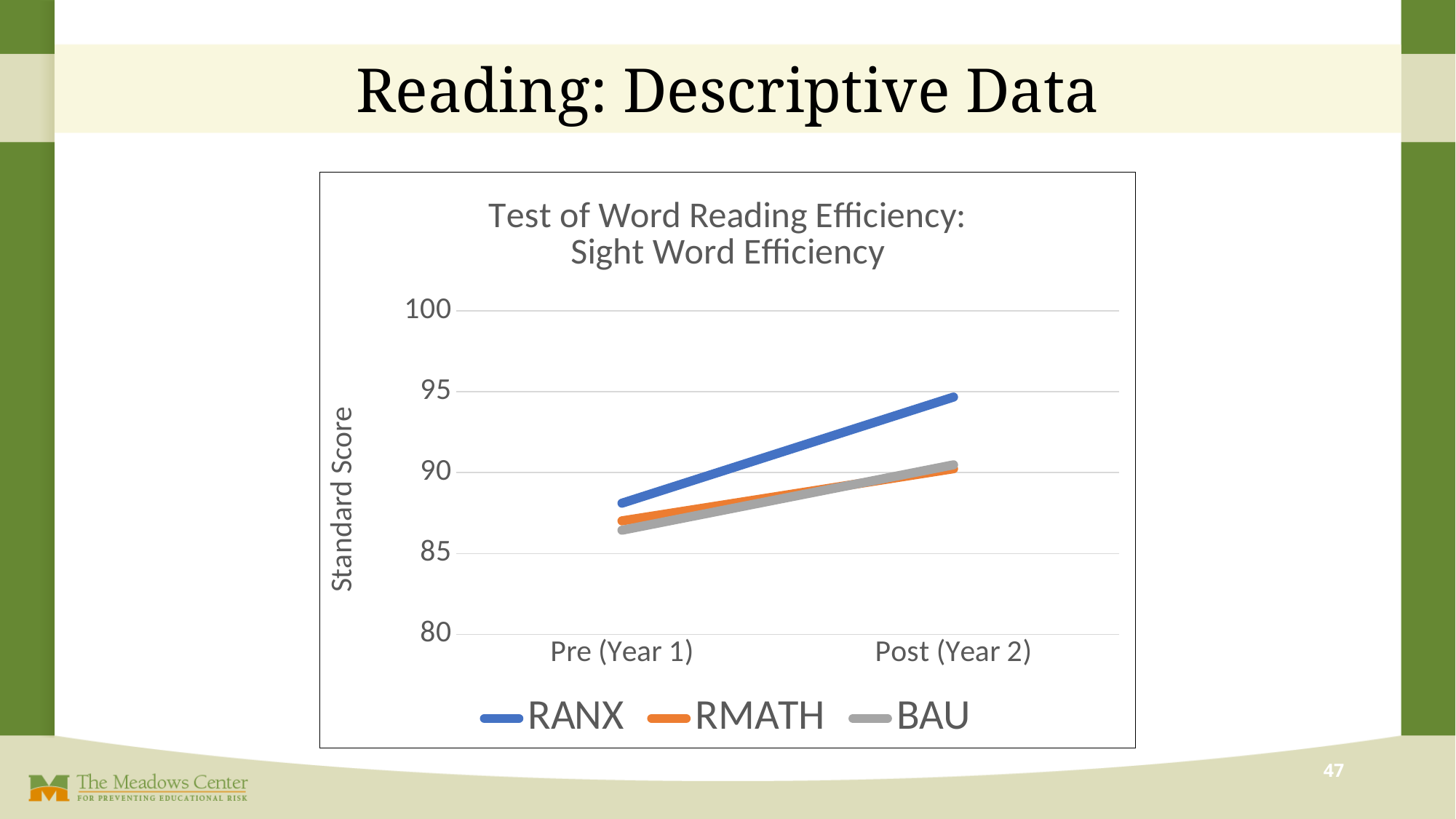
Which series has the highest value at Post (Year 2)? RANX Is the value for RANX at Post (Year 2) greater or less than 90? greater Which is larger at Post (Year 2), RANX or BAU? RANX How many points are on the x axis? 2 Is the value for RMATH at Post (Year 2) greater or less than 85? greater Do the values for RANX rise or fall from Pre (Year 1) to Post (Year 2)? rise What is the title of the chart? Test of Word Reading Efficiency: Sight Word Efficiency Is the value for RANX at Pre (Year 1) greater or less than 90? less What is the label of the y axis? Standard Score How many series does the legend list? 3 What kind of chart is shown on the slide? line chart